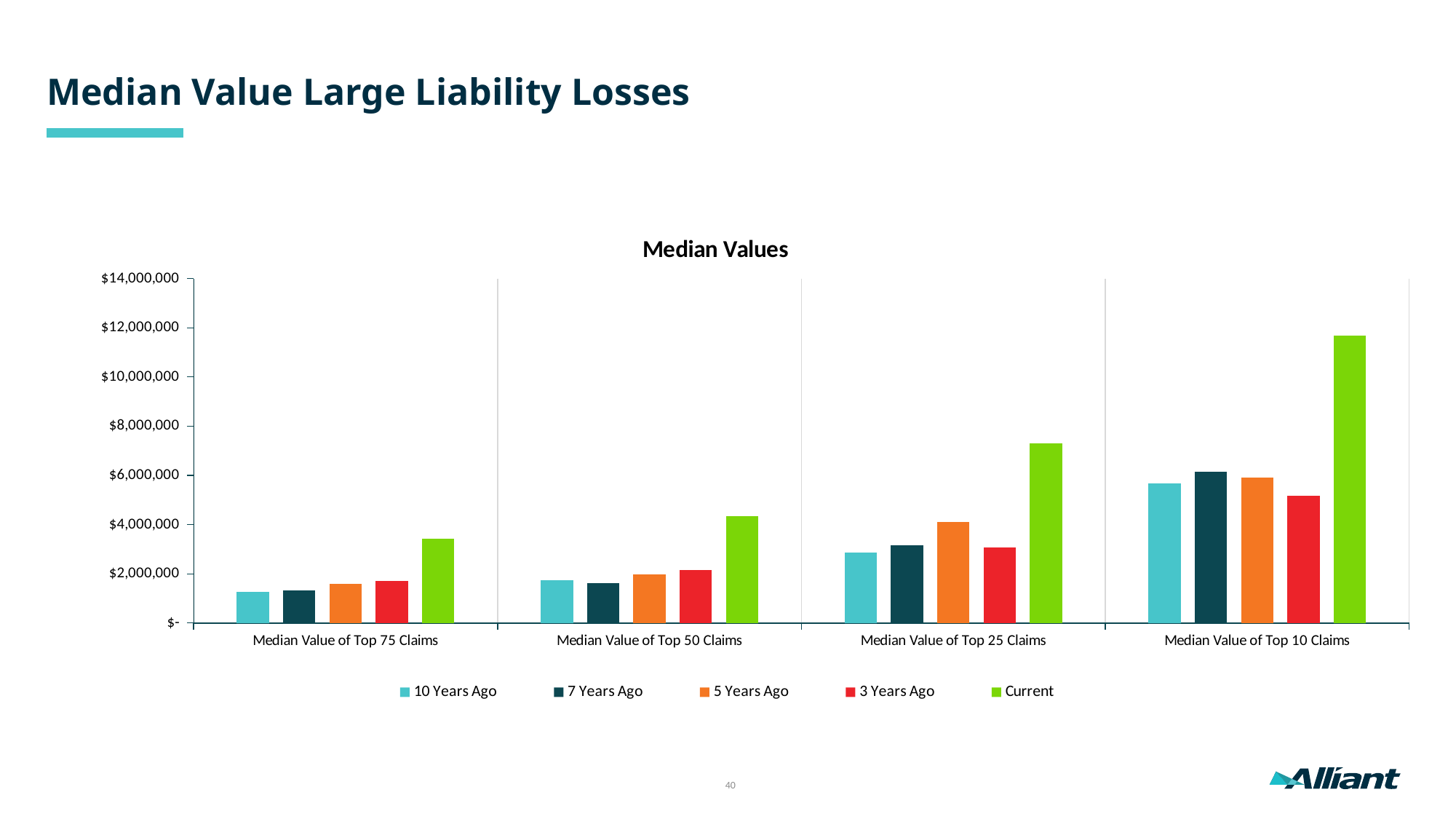
Is the Current value for Median Value of Top 75 Claims greater or less than $4,000,000? less Which category has the highest Current bar? Median Value of Top 10 Claims Is the Current value for Median Value of Top 25 Claims greater or less than $8,000,000? less How many series does the legend list? 5 What is the title of the chart? Median Values How many categories are shown on the x axis? 4 Is the Current value for Median Value of Top 10 Claims greater or less than $10,000,000? greater For Median Value of Top 25 Claims, which is larger: 5 Years Ago or 3 Years Ago? 5 Years Ago For Median Value of Top 10 Claims, which is larger: Current or 10 Years Ago? Current What colour represents the Current series in the legend? Green What kind of chart is shown on the slide? Bar chart For Median Value of Top 10 Claims, which series has the lowest bar? 3 Years Ago